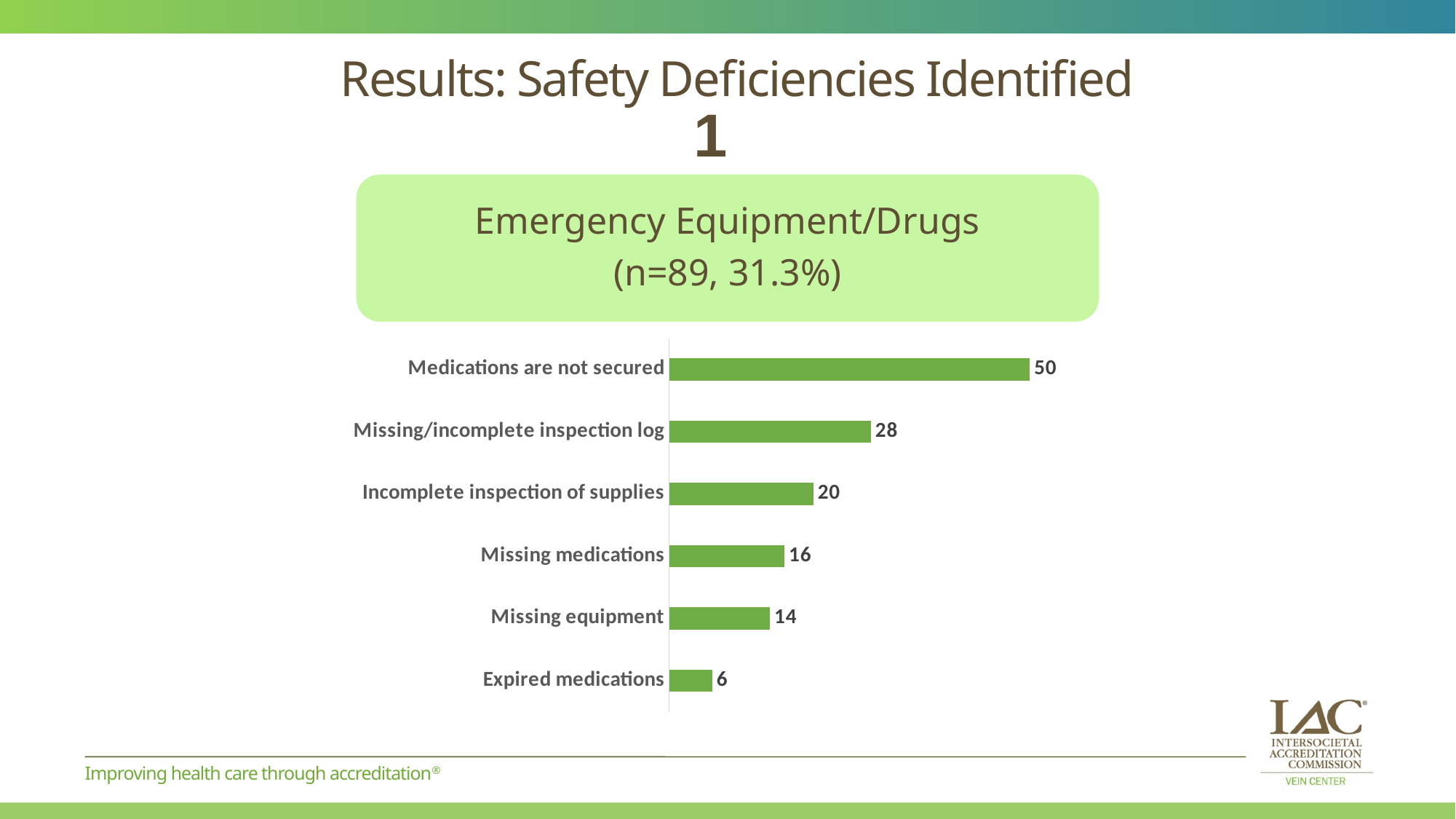
What is the value for Incomplete inspection of supplies? 20 How many categories are shown in the chart? 6 What is the value for Expired medications? 6 What is the heading shown in the green box above the chart? Emergency Equipment/Drugs (n=89, 31.3%) What kind of chart is shown on the slide? Bar chart What is the difference between Medications are not secured and Missing/incomplete inspection log? 22 Which category has the highest value? Medications are not secured What is the value for Missing/incomplete inspection log? 28 Which category has the lowest value? Expired medications What is the difference between Missing medications and Missing equipment? 2 Which is larger, Incomplete inspection of supplies or Missing medications? Incomplete inspection of supplies What is the value for Medications are not secured? 50